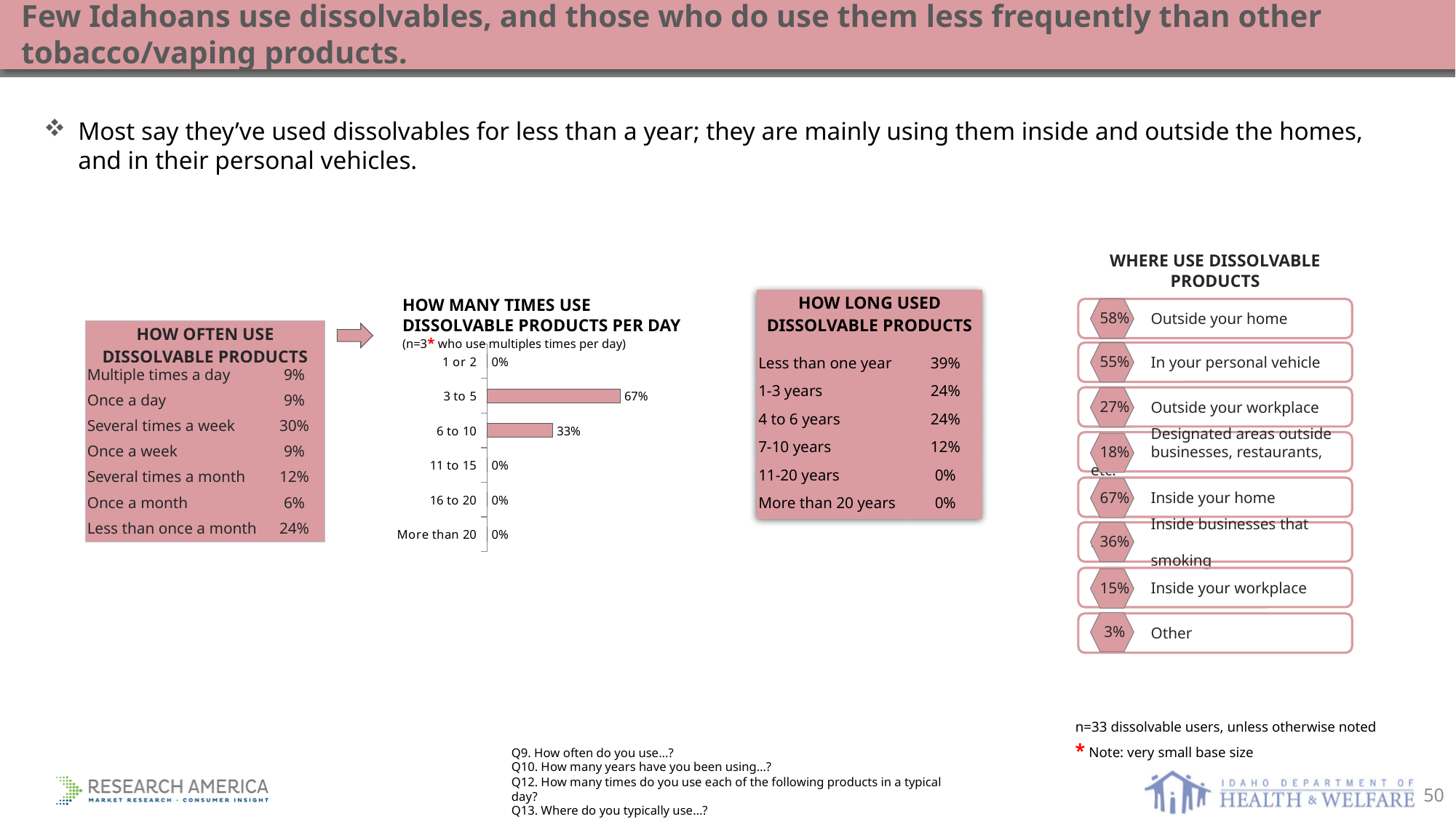
How many categories are shown in the 'How many times use dissolvable products per day' chart? 6 What type of chart is the 'How many times use dissolvable products per day' chart? Bar chart What colour are the bars in the 'How many times use dissolvable products per day' chart? Pink In the 'How many times use dissolvable products per day' chart, what is the value for '3 to 5'? 67% In the 'How many times use dissolvable products per day' chart, what is the value for '1 or 2'? 0% What is the sample size noted under the title of the 'How many times use dissolvable products per day' chart? n=3 In the 'How many times use dissolvable products per day' chart, how many categories have a value of 0%? 4 In the 'How many times use dissolvable products per day' chart, which is larger, the value for '3 to 5' or the value for '6 to 10'? 3 to 5 In the 'How many times use dissolvable products per day' chart, what is the difference between the values for '3 to 5' and '6 to 10'? 34% In the 'How many times use dissolvable products per day' chart, what is the value for 'More than 20'? 0% In the 'How many times use dissolvable products per day' chart, what is the value for '6 to 10'? 33% In the 'How many times use dissolvable products per day' chart, which category has the highest value? 3 to 5